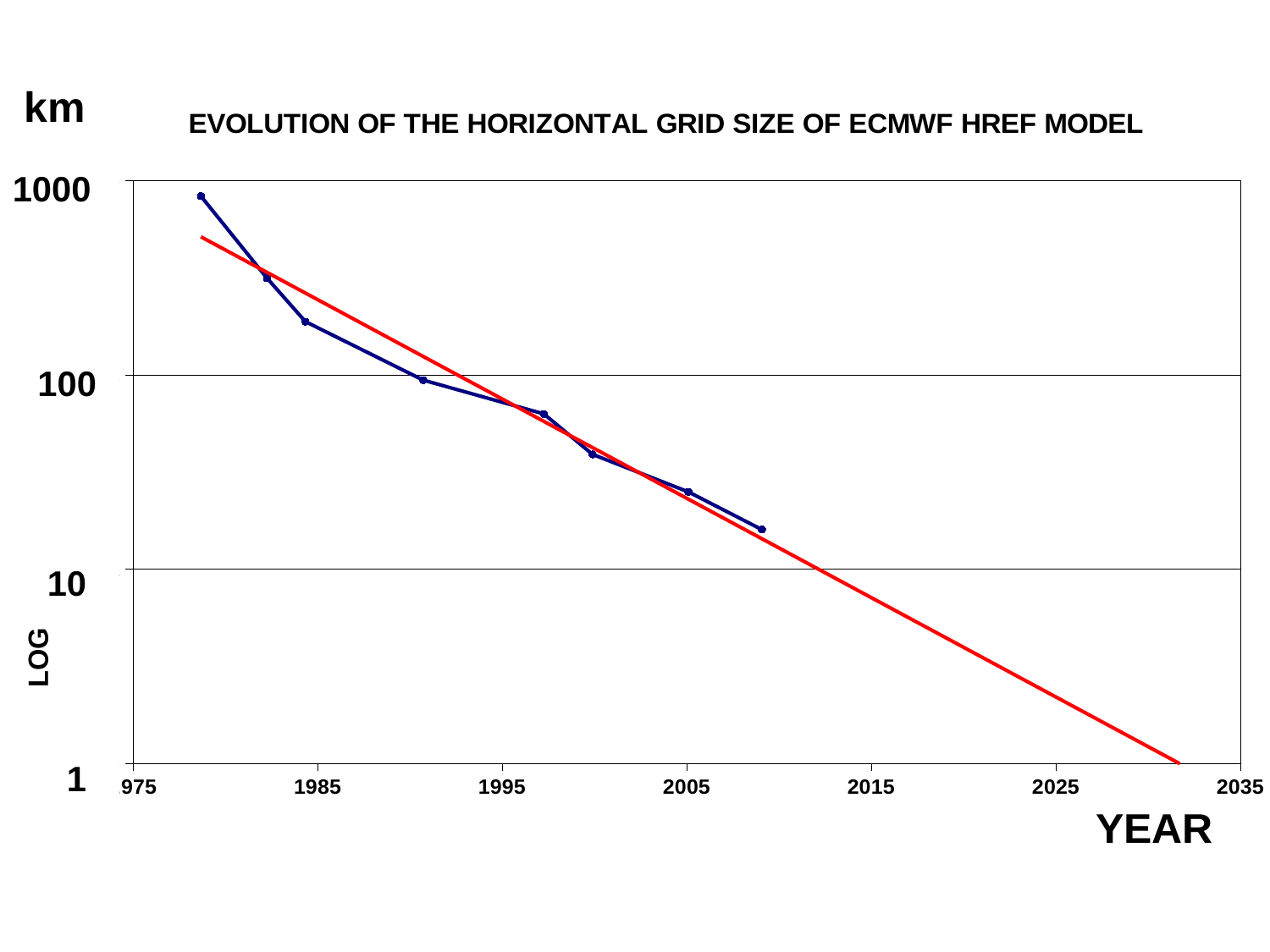
Is the grid size value for the latest plotted point (around 2009) greater or less than 100? less Is the grid size value for the point plotted around 1985 greater or less than 100? greater Which year's plotted point has the lowest grid size value? the latest point, around 2009 Is the grid size value for the latest plotted point (around 2009) greater or less than 10? greater What kind of chart is shown on the slide? line chart What is the title of the chart? EVOLUTION OF THE HORIZONTAL GRID SIZE OF ECMWF HREF MODEL How many data points are plotted on the blue line? 8 Do the plotted grid size values rise or fall as the year increases? fall What is the label of the x axis? YEAR Which plotted point has the highest grid size value, the earliest one (around 1979) or the latest one (around 2009)? the earliest one (around 1979)